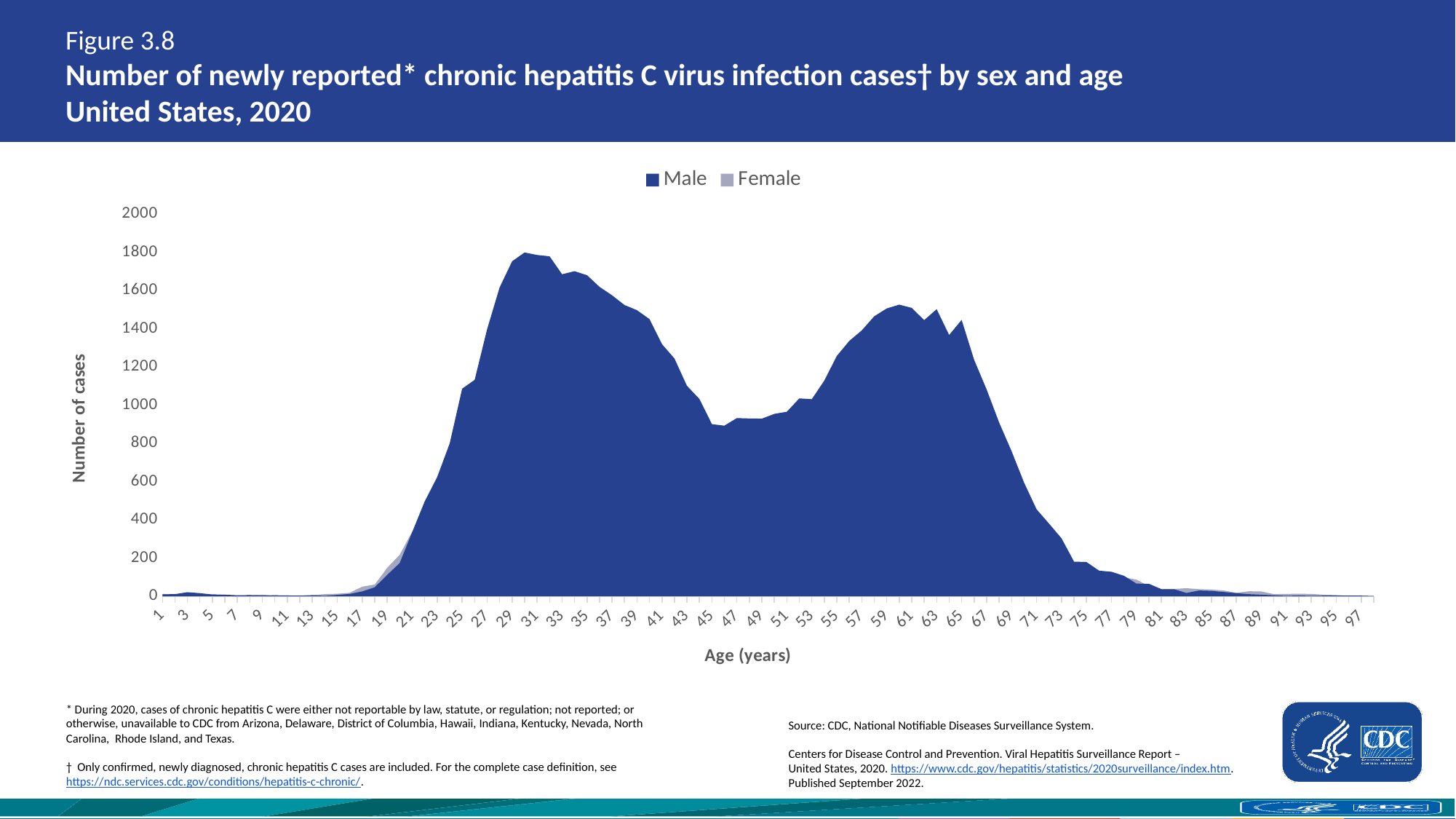
What kind of chart is shown on the slide? area chart Which is larger, the Male value at age 31 or the Male value at age 61? age 31 Do the Male values rise or fall between age 31 and age 45? fall Is the Male value at age 31 greater or less than 1600? greater Is the Male value at age 75 greater or less than 400? less What are the two series named in the legend? Male and Female What is the title of the vertical axis? Number of cases Is the Male value at age 45 greater or less than 1000? less How many series does the legend list? 2 Do the Male values rise or fall between age 47 and age 61? rise